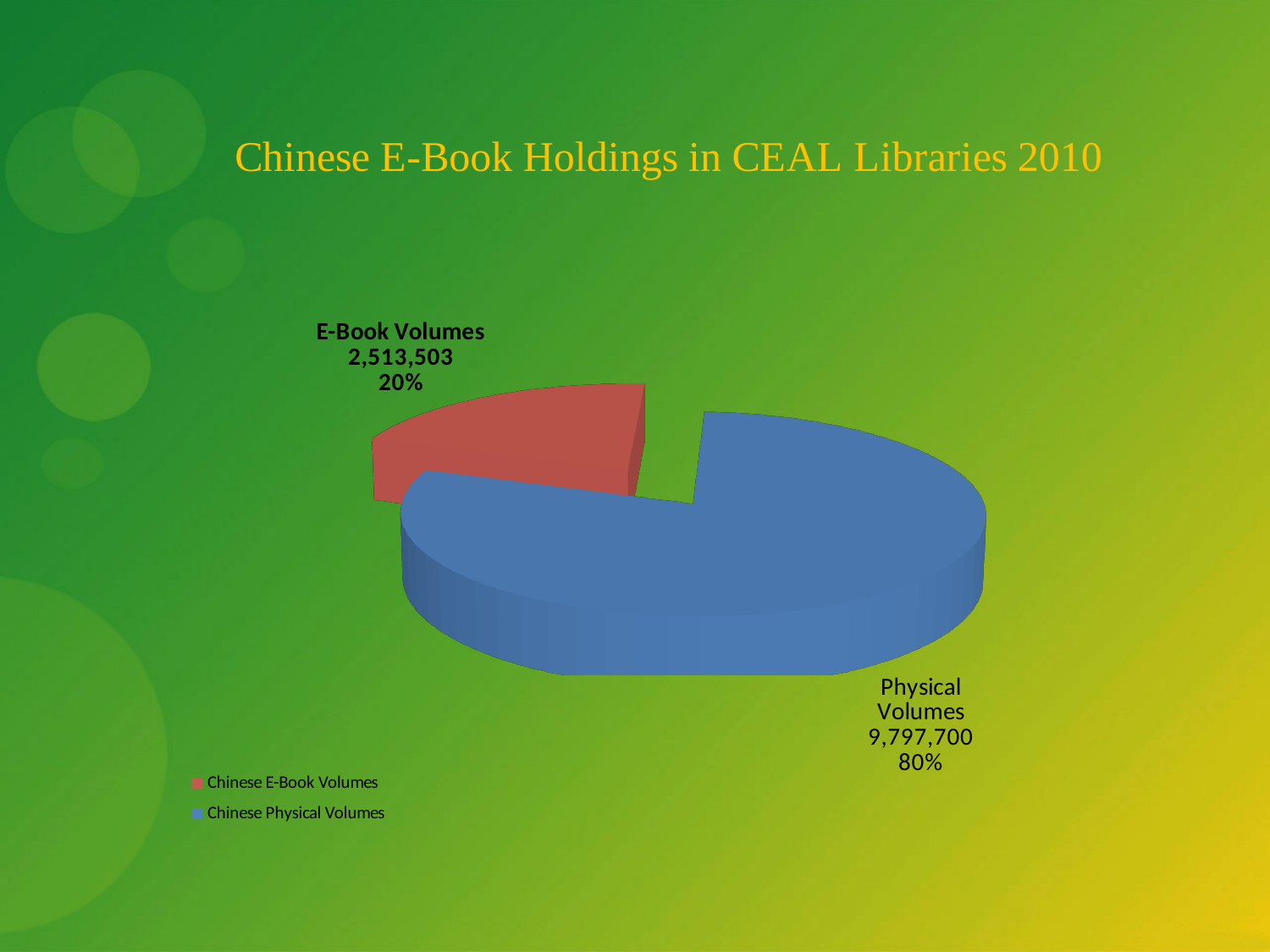
How many slices does the pie chart have? 2 Which slice is the largest? Physical Volumes Which is larger, E-Book Volumes or Physical Volumes? Physical Volumes How many entries does the legend list? 2 Which slice is the smallest? E-Book Volumes What is the difference between Physical Volumes and E-Book Volumes? 7,284,197 What share of the pie do E-Book Volumes represent? 20% What is the value for Physical Volumes? 9,797,700 What is the value for E-Book Volumes? 2,513,503 What share of the pie do Physical Volumes represent? 80% What kind of chart is shown on the slide? pie chart What is the title of the chart? Chinese E-Book Holdings in CEAL Libraries 2010